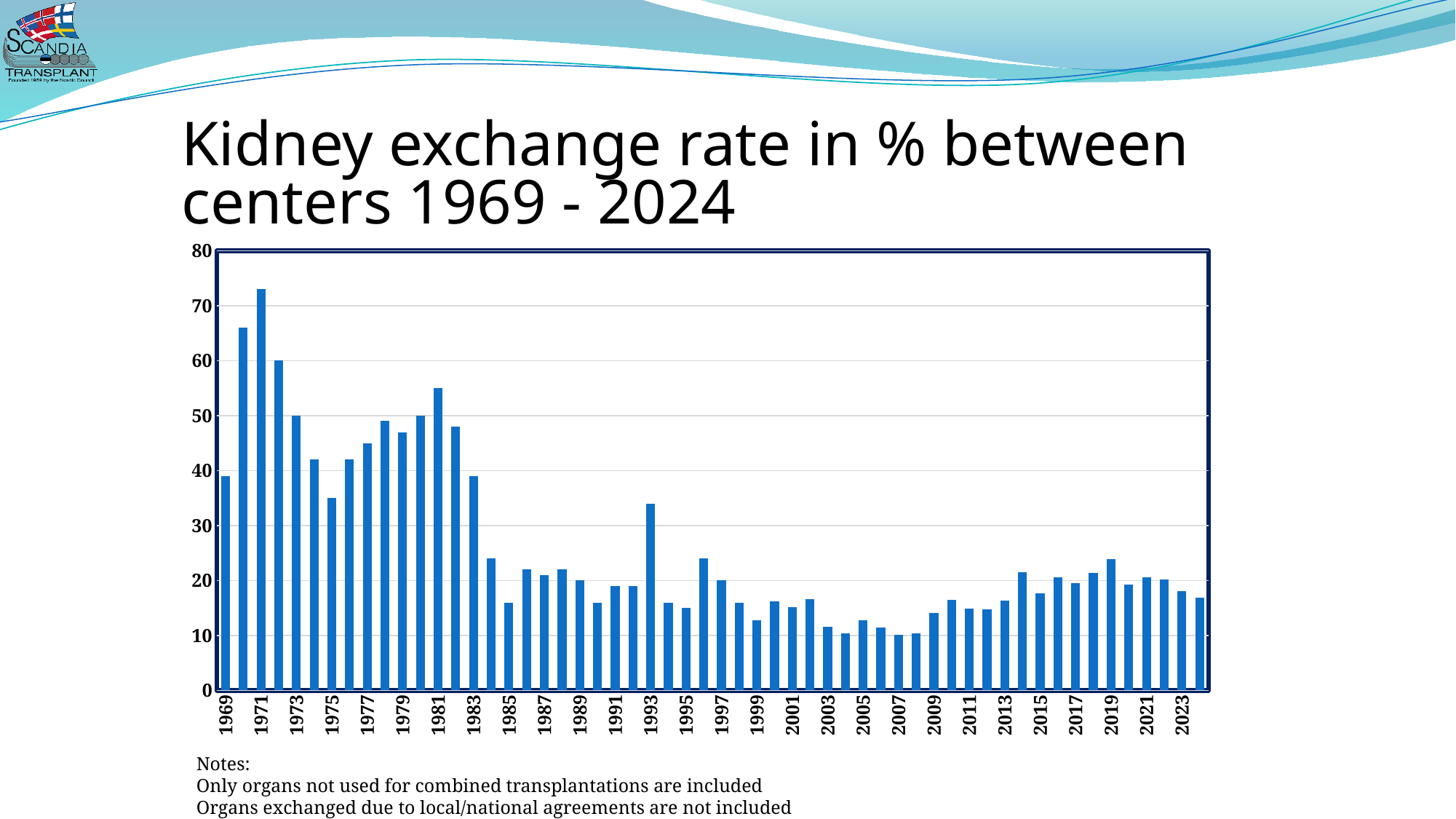
Which year has the larger value, 1971 or 1972? 1971 Is the value for 1969 greater or less than 30? greater Which year has the highest kidney exchange rate? 1971 Which year has the larger value, 1992 or 1993? 1993 Is the value for 2007 greater or less than 20? less What is the title of the chart? Kidney exchange rate in % between centers 1969 - 2024 Do the values generally rise or fall from 1971 to 1985? fall What kind of chart is shown on the slide? bar chart Is the value for 1981 greater or less than 50? greater